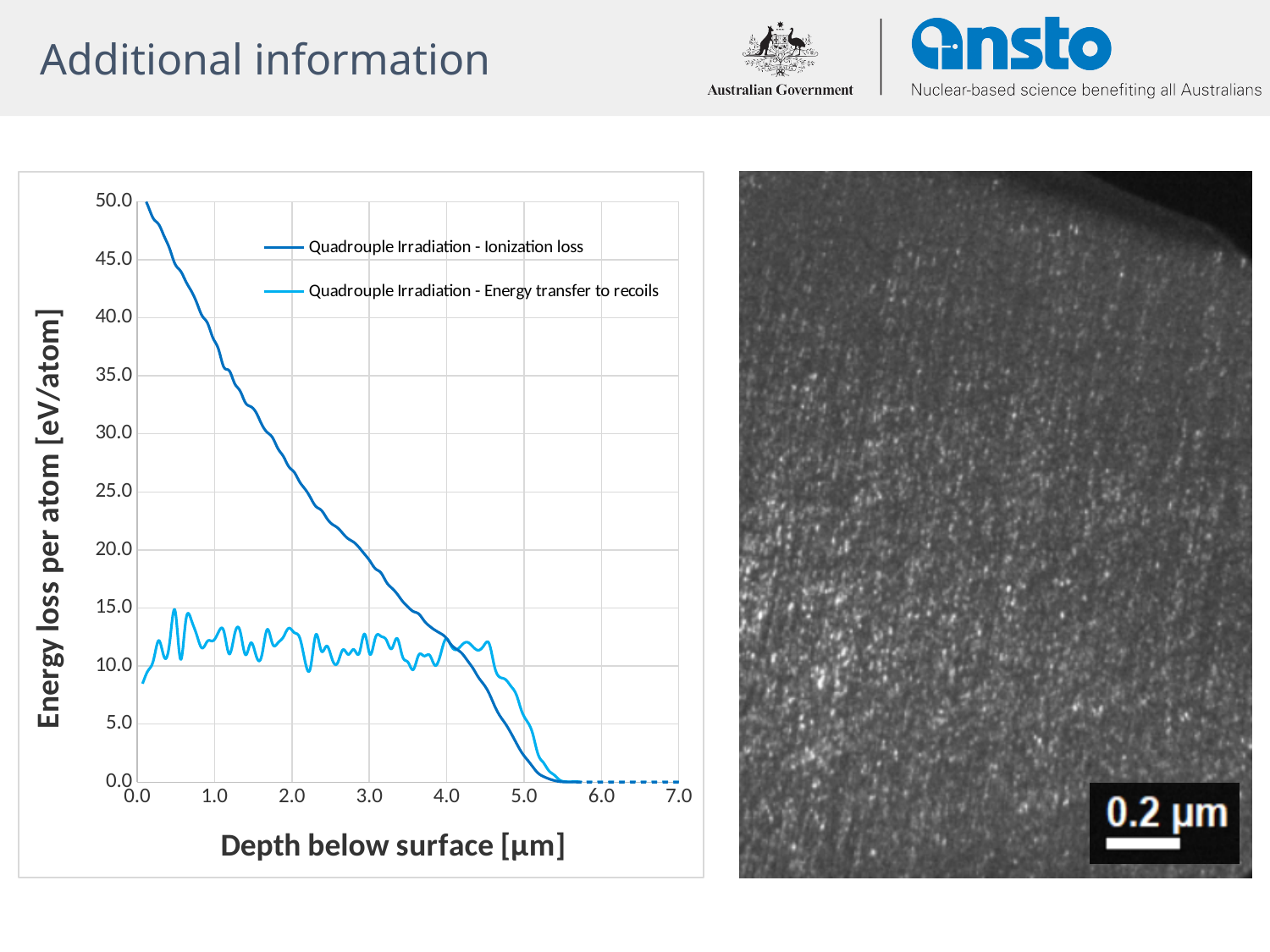
Is the Energy transfer to recoils value at a depth of 2.0 µm greater or less than 10.0? greater How many series does the chart's legend list? 2 Is the Ionization loss value at a depth of 3.0 µm greater or less than 20.0? less At a depth of 1.0 µm, which series has the larger value: Ionization loss or Energy transfer to recoils? Ionization loss What kind of chart is shown on the slide? Line chart Is the Energy transfer to recoils value at a depth of 6.0 µm greater or less than 5.0? less What is the title of the chart's x axis? Depth below surface [µm] What are the two series named in the chart's legend? Quadrouple Irradiation - Ionization loss; Quadrouple Irradiation - Energy transfer to recoils Does the Ionization loss series rise or fall as depth below surface increases? Fall At a depth of 4.5 µm, which series has the larger value: Ionization loss or Energy transfer to recoils? Energy transfer to recoils